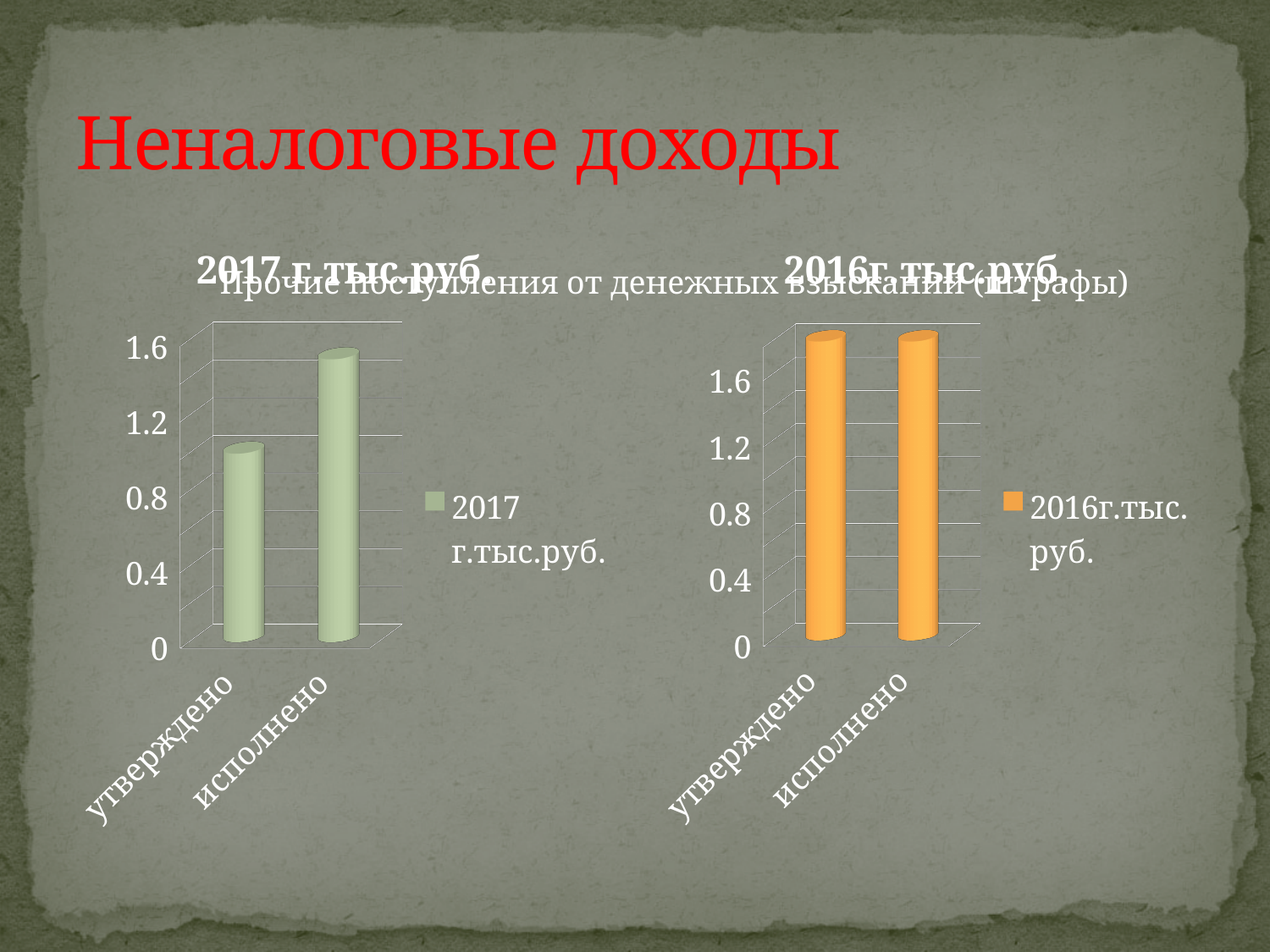
In the left chart (2017 г. тыс.руб.), which is larger: утверждено or исполнено? исполнено In the left chart (2017 г. тыс.руб.), which category has the highest value? исполнено How many series does the legend of the left chart (2017 г. тыс.руб.) list? 1 In the left chart (2017 г. тыс.руб.), is the value for исполнено greater or less than 1.2? greater In the left chart (2017 г. тыс.руб.), do the values rise or fall from утверждено to исполнено? rise In the right chart (2016г. тыс.руб.), is the value for исполнено greater or less than 1.2? greater What kind of chart is the left chart titled "2017 г. тыс.руб."? bar chart What colour are the bars in the right chart (2016г. тыс.руб.)? orange How many categories are shown on the x axis of the right chart (2016г. тыс.руб.)? 2 In the left chart (2017 г. тыс.руб.), is the value for утверждено greater or less than 1.2? less In the left chart (2017 г. тыс.руб.), which category has the lowest value? утверждено